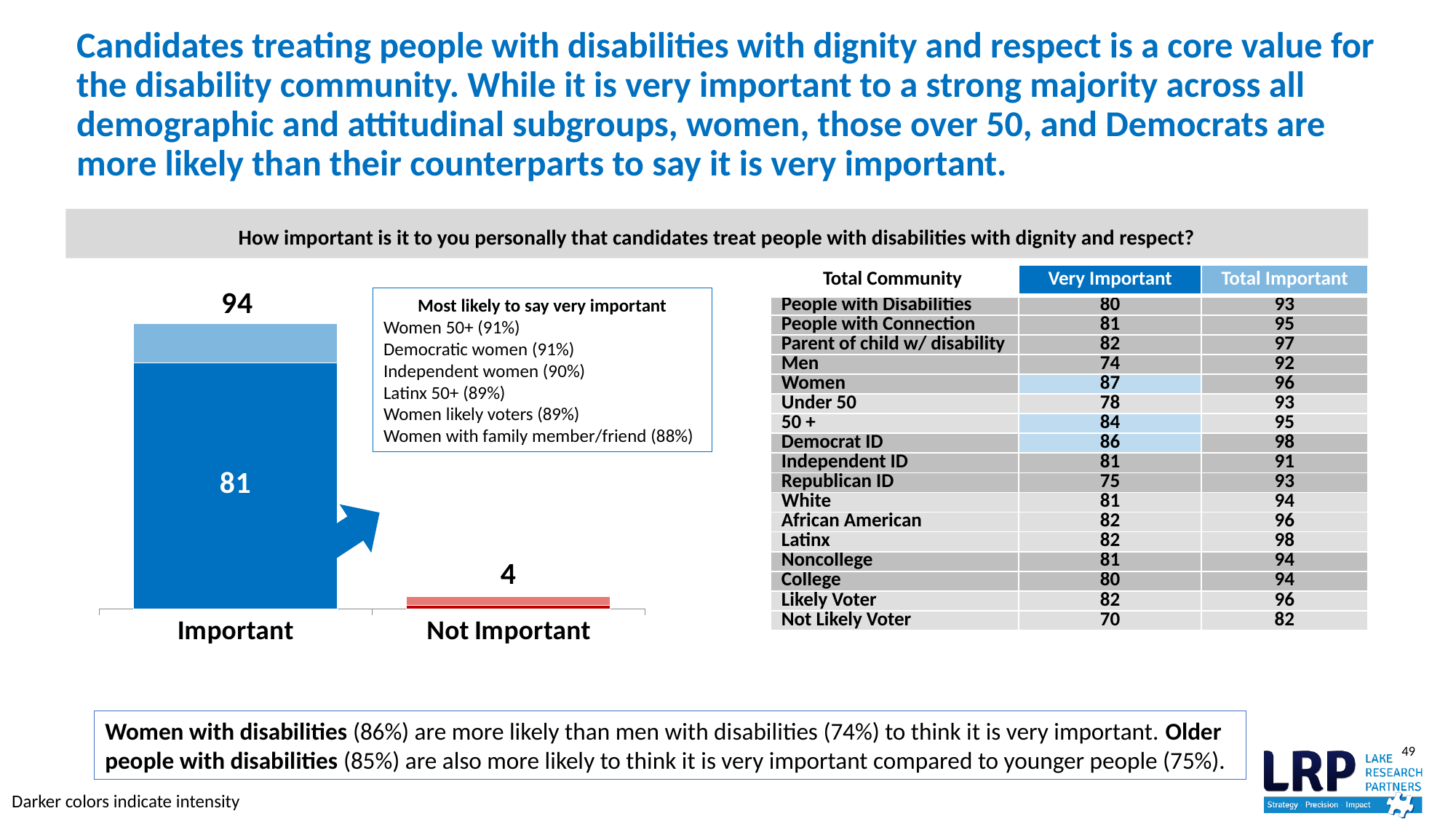
Which is larger in the bar chart, Important or Not Important? Important What is the difference between the total for Important (94) and the value for Not Important (4)? 90 What is the difference between the Important bar's total of 94 and its dark blue segment of 81? 13 What kind of chart is shown on the left of the slide? bar chart Which category in the bar chart has the lowest value? Not Important Which category in the bar chart has the highest value? Important According to the note at the bottom left of the slide, what do darker colours in the chart indicate? intensity What is the total value shown above the Important bar? 94 What colour is the Not Important bar in the chart? red What is the value shown for Not Important in the bar chart? 4 What value is printed inside the dark blue segment of the Important bar? 81 How many categories are shown on the x axis of the bar chart? 2